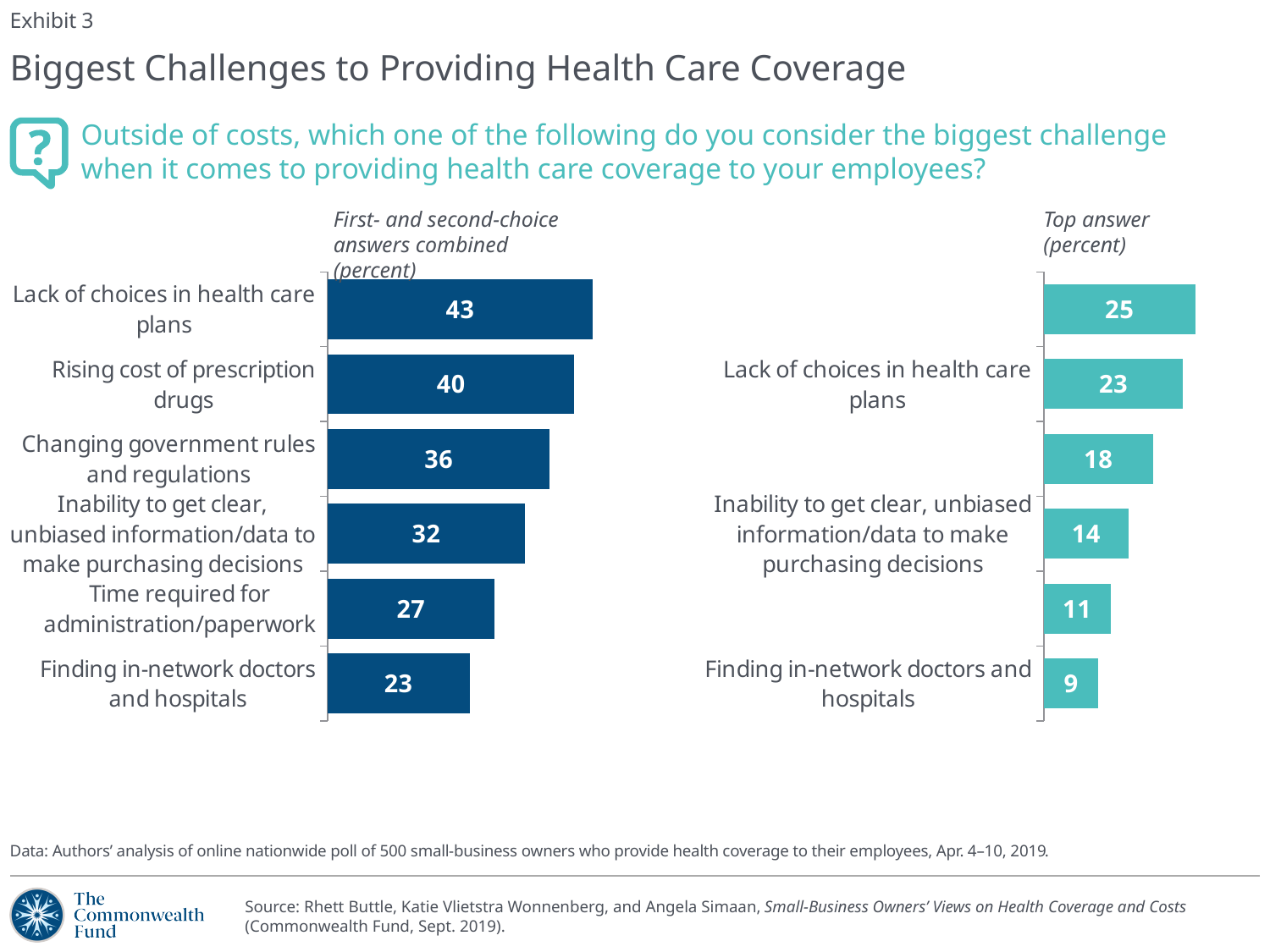
What is the title of the slide? Biggest Challenges to Providing Health Care Coverage How many categories are shown on the 'First- and second-choice answers combined (percent)' chart? 6 On the 'Top answer (percent)' chart, what is the value for 'Finding in-network doctors and hospitals'? 9 On the 'First- and second-choice answers combined (percent)' chart, which category has the highest value? Lack of choices in health care plans On the 'Top answer (percent)' chart, what is the highest value shown? 25 On the 'Top answer (percent)' chart, what is the value for 'Inability to get clear, unbiased information/data to make purchasing decisions'? 14 On the 'First- and second-choice answers combined (percent)' chart, which category has the lowest value? Finding in-network doctors and hospitals What type of chart is the 'Top answer (percent)' chart? Bar chart On the 'First- and second-choice answers combined (percent)' chart, what is the value for 'Time required for administration/paperwork'? 27 On the 'First- and second-choice answers combined (percent)' chart, which is larger: 'Inability to get clear, unbiased information/data to make purchasing decisions' or 'Time required for administration/paperwork'? Inability to get clear, unbiased information/data to make purchasing decisions On the 'First- and second-choice answers combined (percent)' chart, what is the difference between 'Rising cost of prescription drugs' and 'Changing government rules and regulations'? 4 On the 'First- and second-choice answers combined (percent)' chart, what is the value for 'Lack of choices in health care plans'? 43